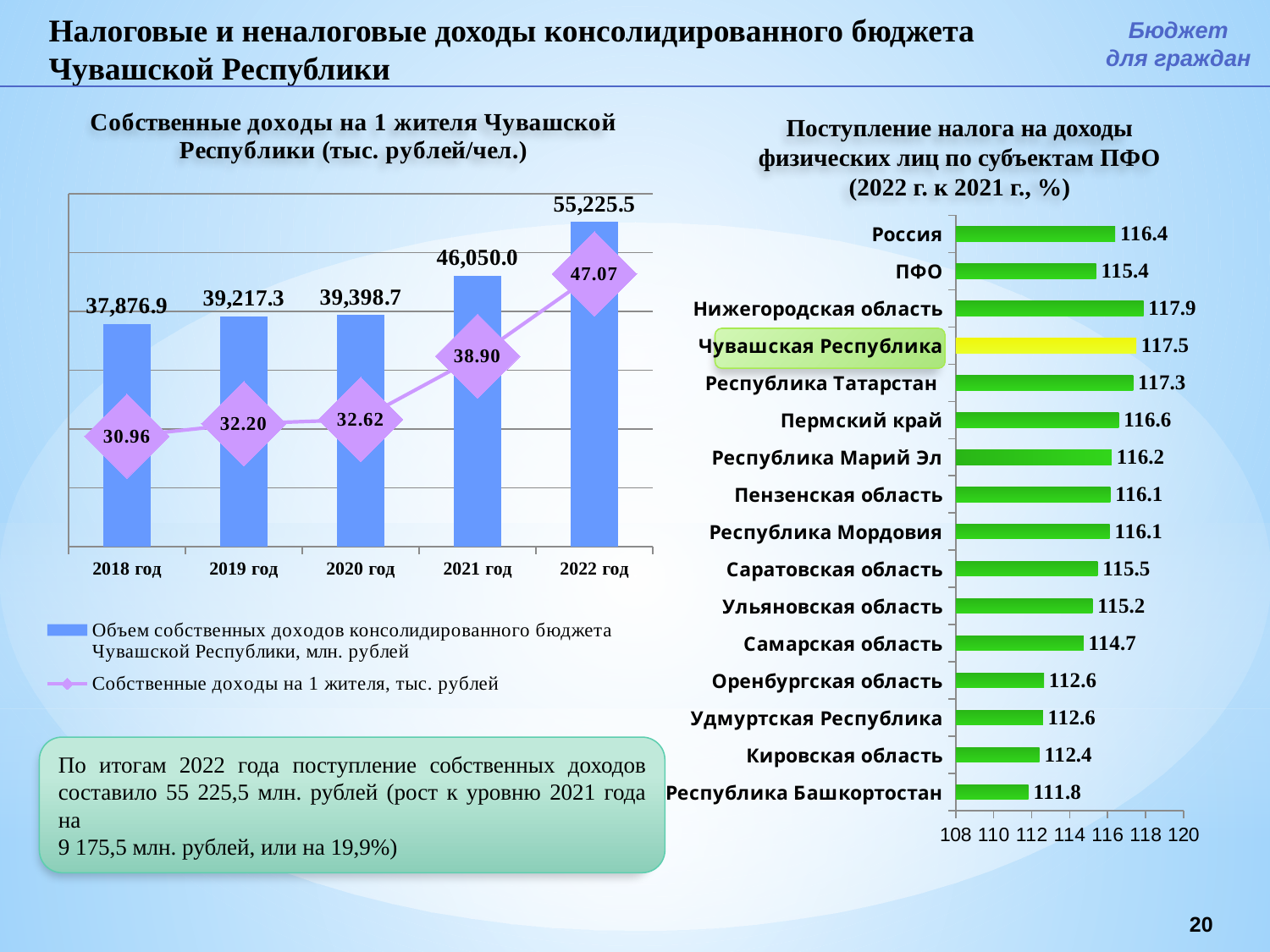
In the left chart (Собственные доходы на 1 жителя Чувашской Республики), what is the value of the bar for 2022 год? 55,225.5 What type of chart is the right chart? bar chart In the right chart, which is larger: the value for Самарская область or the value for Саратовская область? Саратовская область In the right chart, which region has the lowest value? Республика Башкортостан How many categories are shown in the right chart? 16 In the right chart (Поступление налога на доходы физических лиц по субъектам ПФО), what is the value for Чувашская Республика? 117.5 In the right chart, which region has the highest value? Нижегородская область In the left chart, which year has the lowest bar value? 2018 год In the left chart, do the line values rise or fall from 2018 год to 2022 год? rise How many series does the legend of the left chart list? 2 In the left chart, what is the difference between the bar values for 2022 год and 2021 год? 9,175.5 In the left chart, what is the value of the line marker for 2019 год? 32.20